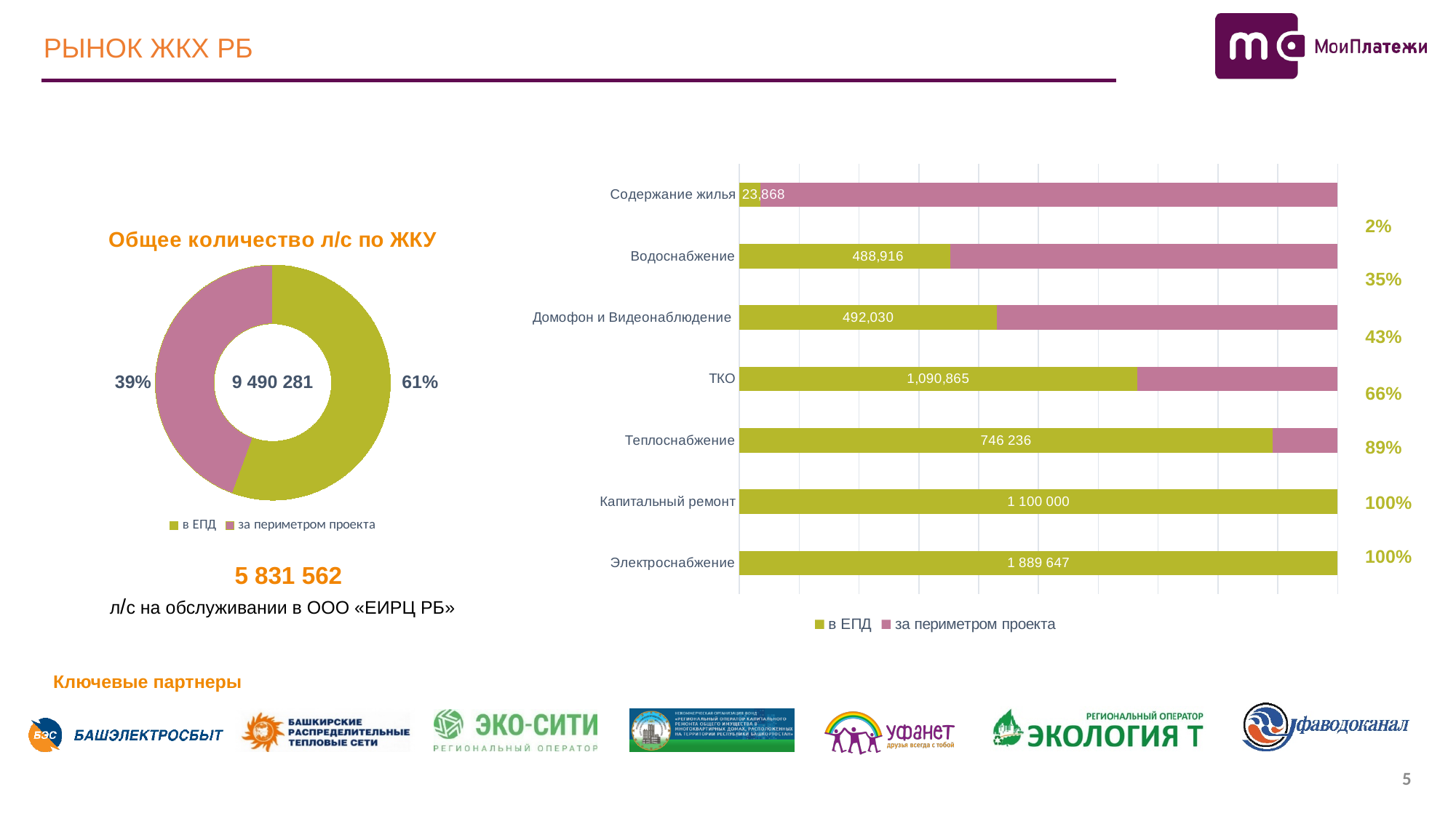
In the stacked bar chart on the right, what percentage is shown to the right of the «Теплоснабжение» bar? 89% In the donut chart on the left, which segment is larger, «в ЕПД» or «за периметром проекта»? в ЕПД In the stacked bar chart on the right, what value is labelled on the «в ЕПД» bar for «Содержание жилья»? 23,868 In the donut chart titled «Общее количество л/с по ЖКУ», what share is labelled for «за периметром проекта»? 39% In the donut chart on the left, what number is printed in the centre of the ring? 9 490 281 In the donut chart titled «Общее количество л/с по ЖКУ», what share is labelled for «в ЕПД»? 61% In the stacked bar chart on the right, what value is labelled on the «в ЕПД» bar for «ТКО»? 1,090,865 How many series does the legend of the stacked bar chart on the right list? 2 In the stacked bar chart on the right, which category has the highest labelled «в ЕПД» value? Электроснабжение In the stacked bar chart on the right, what value is labelled on the «в ЕПД» bar for «Электроснабжение»? 1 889 647 In the stacked bar chart on the right, which category has the lowest labelled «в ЕПД» value? Содержание жилья How many categories are shown in the stacked bar chart on the right? 7